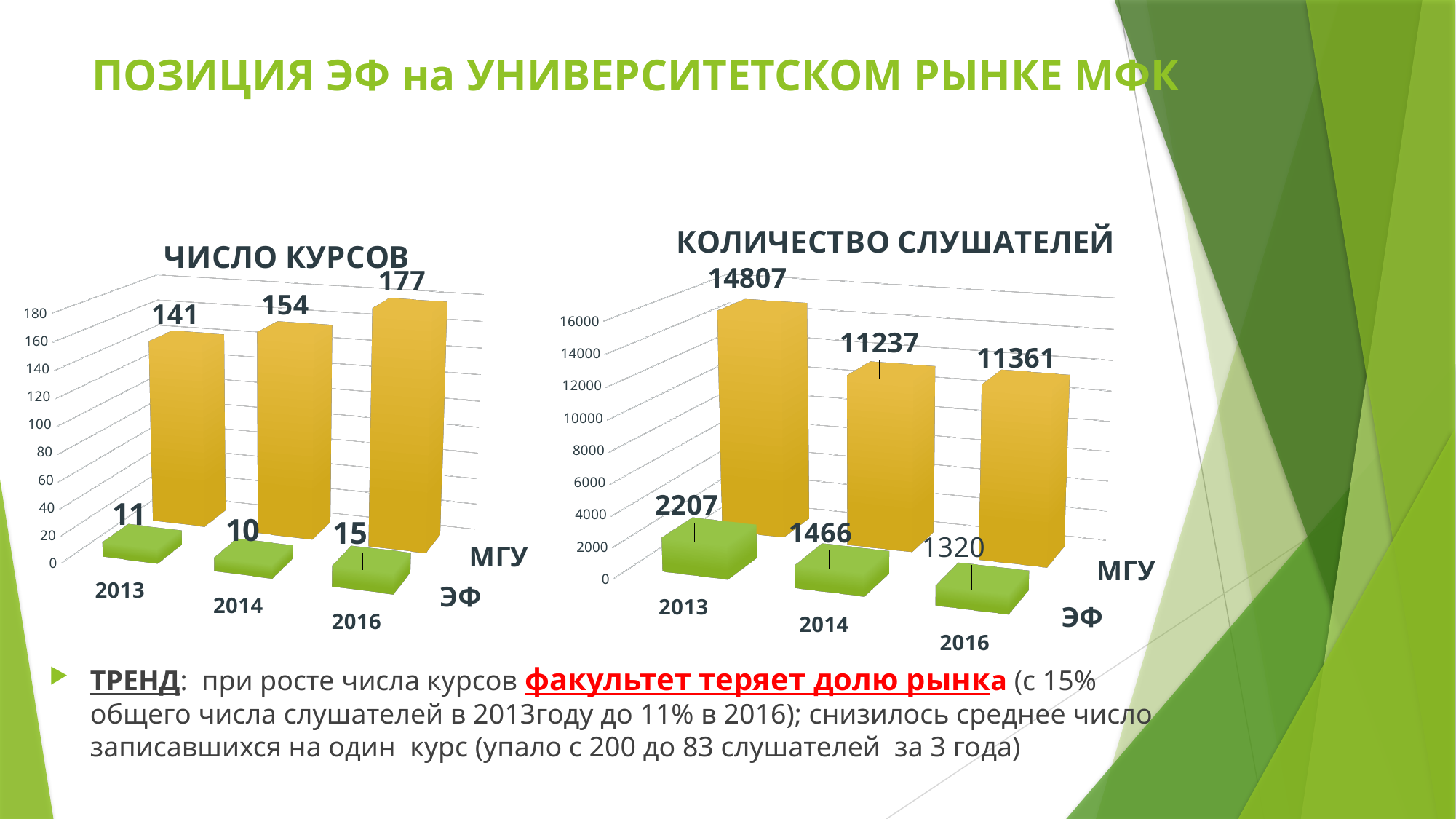
In the chart titled "ЧИСЛО КУРСОВ", what is the difference between the МГУ values for 2016 and 2013? 36 In the chart titled "ЧИСЛО КУРСОВ", what is the value for МГУ in 2016? 177 In the chart titled "КОЛИЧЕСТВО СЛУШАТЕЛЕЙ", which year has the highest value for МГУ? 2013 What kind of chart is the chart titled "ЧИСЛО КУРСОВ"? bar chart In the chart titled "КОЛИЧЕСТВО СЛУШАТЕЛЕЙ", what is the value for ЭФ in 2016? 1320 In the chart titled "КОЛИЧЕСТВО СЛУШАТЕЛЕЙ", what is the difference between the ЭФ values for 2013 and 2014? 741 In the chart titled "ЧИСЛО КУРСОВ", which year has the lowest value for ЭФ? 2014 In the chart titled "ЧИСЛО КУРСОВ", do the МГУ values rise or fall from 2013 to 2016? rise In the chart titled "КОЛИЧЕСТВО СЛУШАТЕЛЕЙ", what is the value for МГУ in 2013? 14807 In the chart titled "КОЛИЧЕСТВО СЛУШАТЕЛЕЙ", which is larger: the МГУ value for 2014 or for 2016? 2016 In the chart titled "ЧИСЛО КУРСОВ", what is the value for ЭФ in 2014? 10